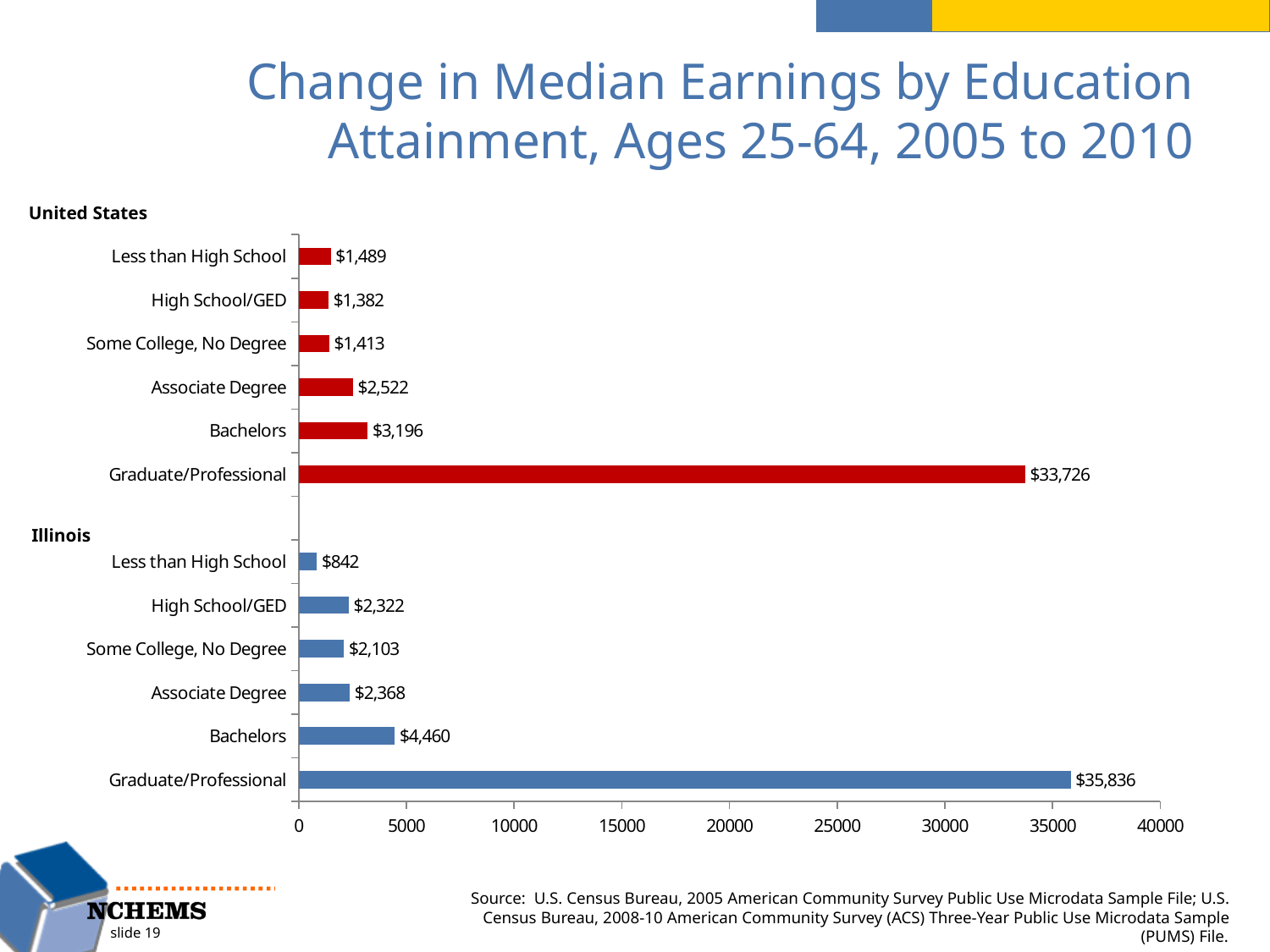
What is the change in median earnings for Graduate/Professional in the United States? $33,726 What is the difference between the Bachelors values for Illinois and the United States? $1,264 Which education level has the lowest change in median earnings in the United States? High School/GED How many bars are plotted in the chart in total? 12 What is the change in median earnings for Bachelors in Illinois? $4,460 Which is larger, the High School/GED value for the United States or for Illinois? Illinois What kind of chart is shown on the slide? Bar chart What is the difference between the Graduate/Professional values for Illinois and the United States? $2,110 Which education level has the lowest change in median earnings in Illinois? Less than High School Which education level has the highest change in median earnings in Illinois? Graduate/Professional What is the change in median earnings for Associate Degree in the United States? $2,522 What is the change in median earnings for Less than High School in Illinois? $842